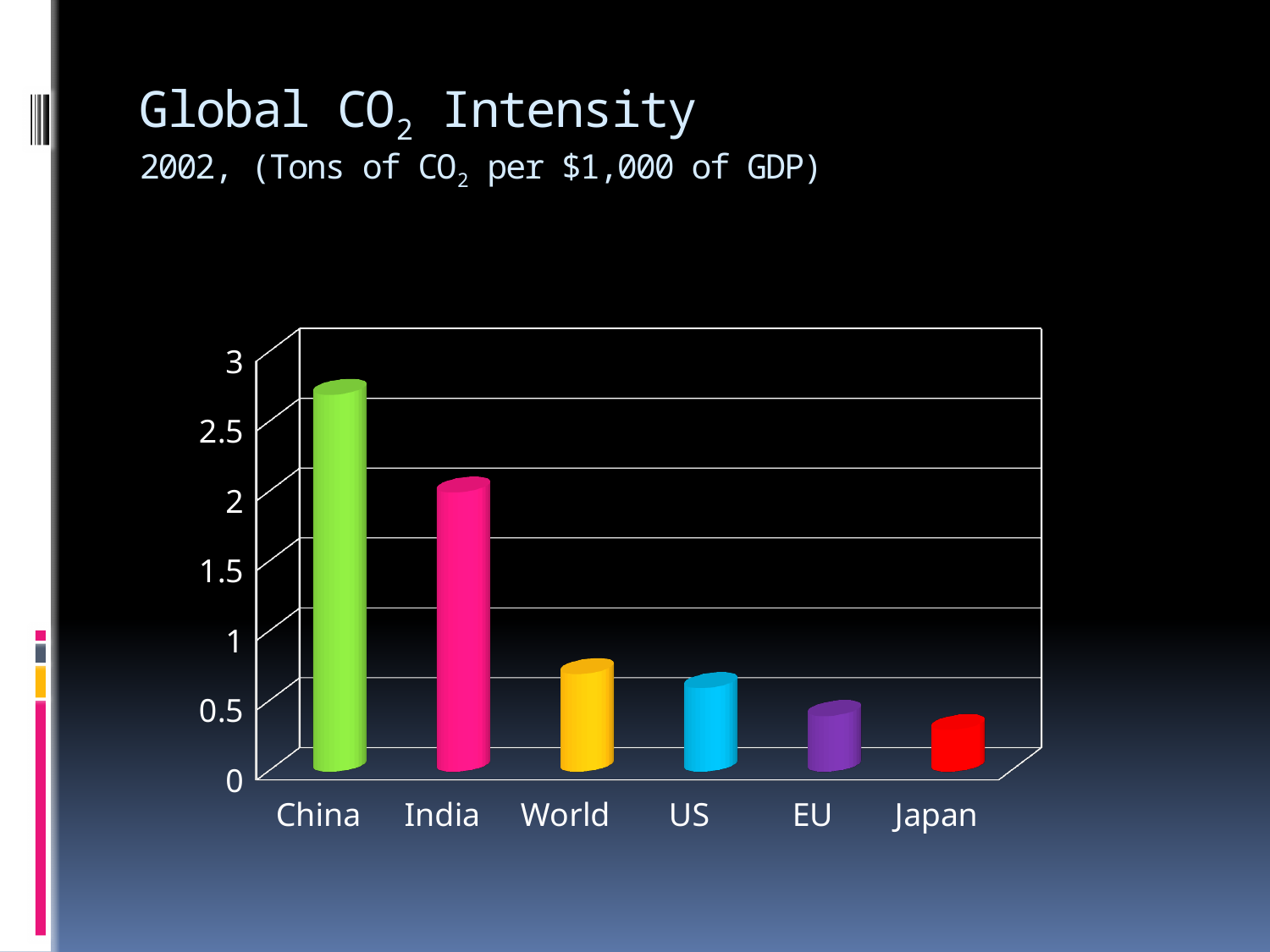
Do the values rise or fall moving from left to right along the x axis? fall Which category has the highest CO2 intensity in the chart? China Is the value for World greater or less than 1? less How many categories are shown on the x axis of the chart? 6 What colour is the bar for China? green Is the value for Japan greater or less than 0.5? less Which has a higher CO2 intensity, China or India? China What kind of chart is shown on the slide? bar chart Which category has the lowest CO2 intensity in the chart? Japan Is the value for India greater or less than 1.5? greater